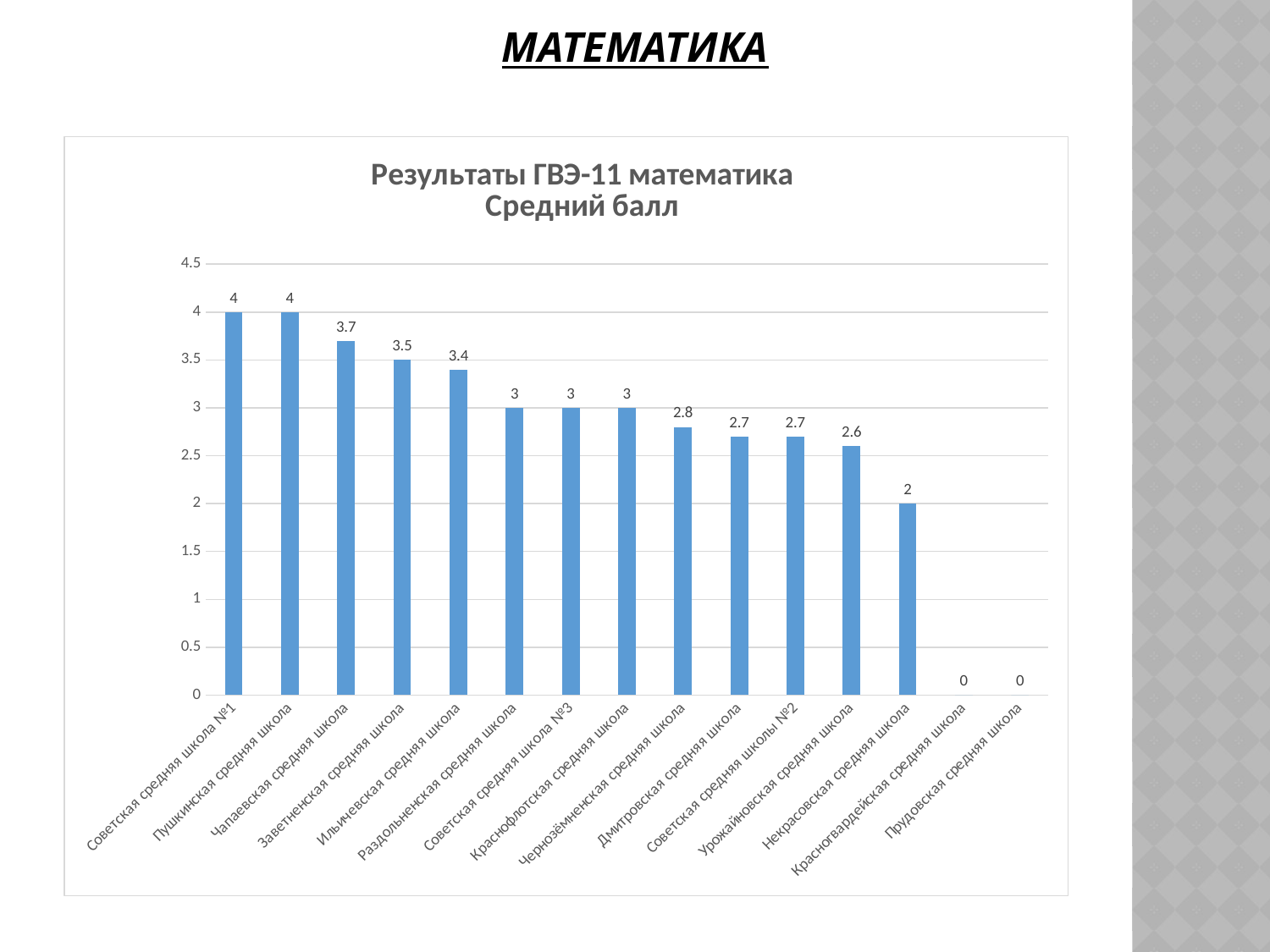
What is the title of the chart? Результаты ГВЭ-11 математика Средний балл Which has a higher score, Чапаевская средняя школа or Дмитровская средняя школа? Чапаевская средняя школа How many schools are shown on the x axis of the chart? 15 What is the average score for Некрасовская средняя школа? 2 What is the average score for Чапаевская средняя школа? 3.7 What is the average score for Чернозёмненская средняя школа? 2.8 What kind of chart is shown on the slide? bar chart What is the average score for Урожайновская средняя школа? 2.6 What is the average score for Ильичевская средняя школа? 3.4 How many schools have an average score of 0? 2 What is the difference between the scores of Заветненская средняя школа and Некрасовская средняя школа? 1.5 Do the values generally rise or fall from left to right along the x axis? fall